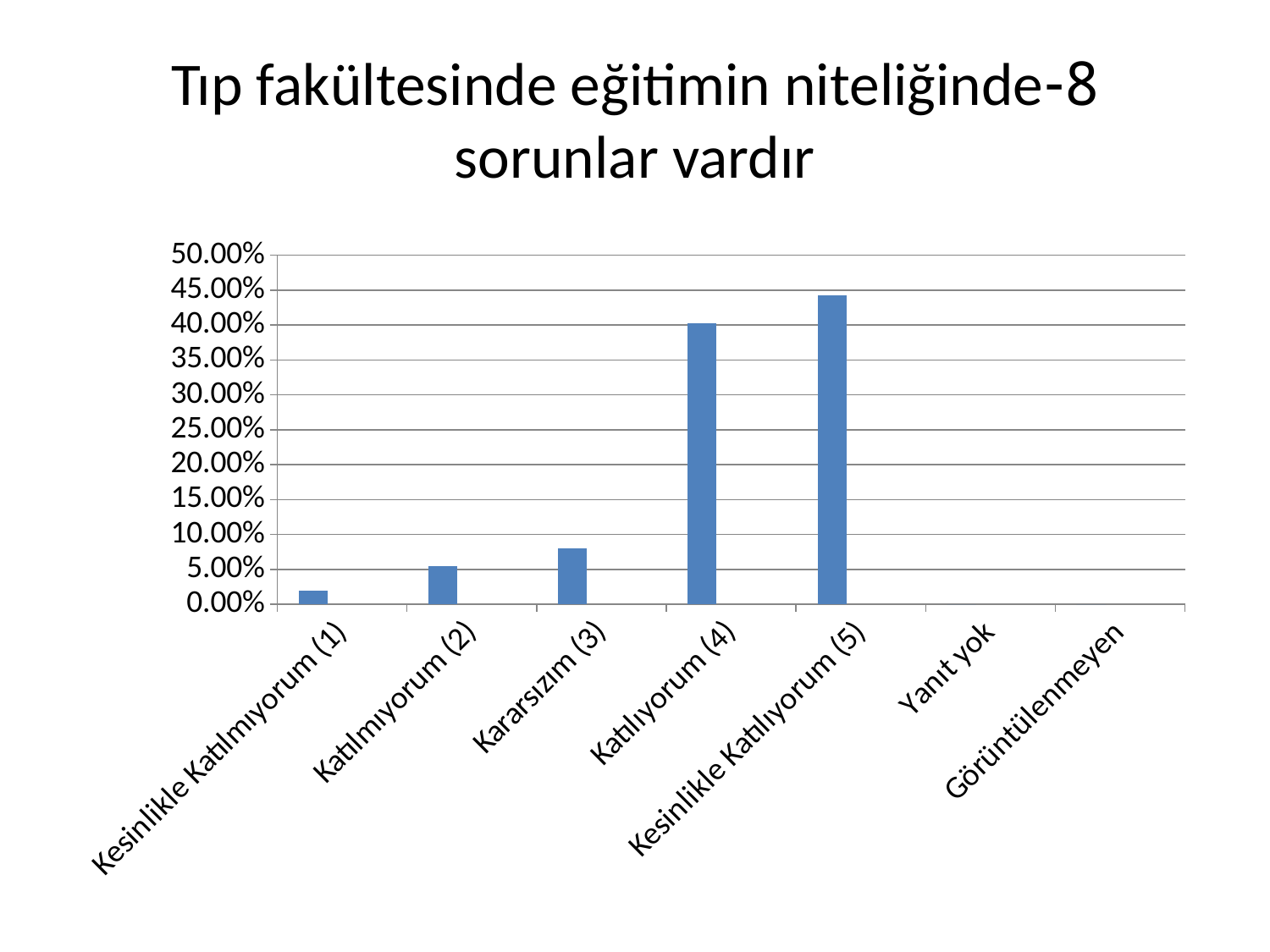
Which is larger, the value for Katılıyorum (4) or the value for Kesinlikle Katılıyorum (5)? Kesinlikle Katılıyorum (5) Which is larger, the value for Kararsızım (3) or the value for Katılmıyorum (2)? Kararsızım (3) Which category has the highest value? Kesinlikle Katılıyorum (5) Is the value for Kesinlikle Katılıyorum (5) greater or less than 45.00%? less Is the value for Kararsızım (3) greater or less than 10.00%? less How many categories are shown on the x axis? 7 Do the values rise or fall from Kesinlikle Katılmıyorum (1) to Kesinlikle Katılıyorum (5)? rise Is the value for Kesinlikle Katılmıyorum (1) greater or less than 5.00%? less What kind of chart is shown on the slide? bar chart What is the title of the slide? Tıp fakültesinde eğitimin niteliğinde-8 sorunlar vardır